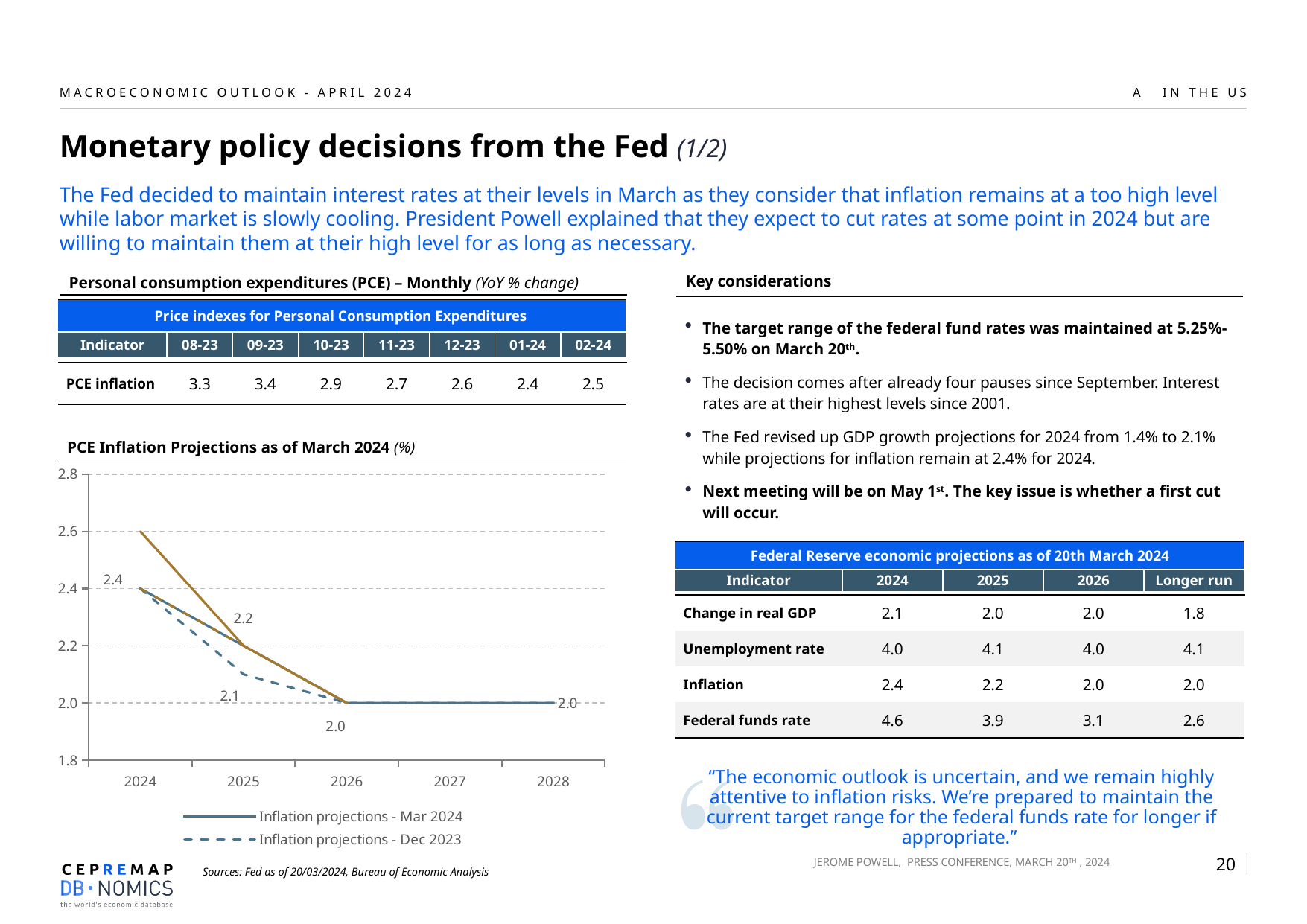
What kind of chart is the 'PCE Inflation Projections as of March 2024' chart? line chart How many years are shown on the x axis of the PCE Inflation Projections chart? 5 In the PCE Inflation Projections chart, what is the Mar 2024 inflation projection for 2025? 2.2 In the PCE Inflation Projections chart, what is the Dec 2023 inflation projection for 2025? 2.1 In the PCE Inflation Projections chart, what is the Mar 2024 inflation projection for 2026? 2.0 In the PCE Inflation Projections chart, what is the inflation projection shown for 2028? 2.0 In the PCE Inflation Projections chart, for 2025, which is larger: the Mar 2024 projection or the Dec 2023 projection? Mar 2024 projection How many series does the legend of the PCE Inflation Projections chart list? 2 What are the two legend entries of the PCE Inflation Projections chart? Inflation projections - Mar 2024; Inflation projections - Dec 2023 In the PCE Inflation Projections chart, which year has the highest Mar 2024 inflation projection? 2024 In the PCE Inflation Projections chart, do the Mar 2024 projections rise or fall from 2024 to 2026? fall In the PCE Inflation Projections chart, what is the difference between the Mar 2024 projections for 2025 and 2026? 0.2